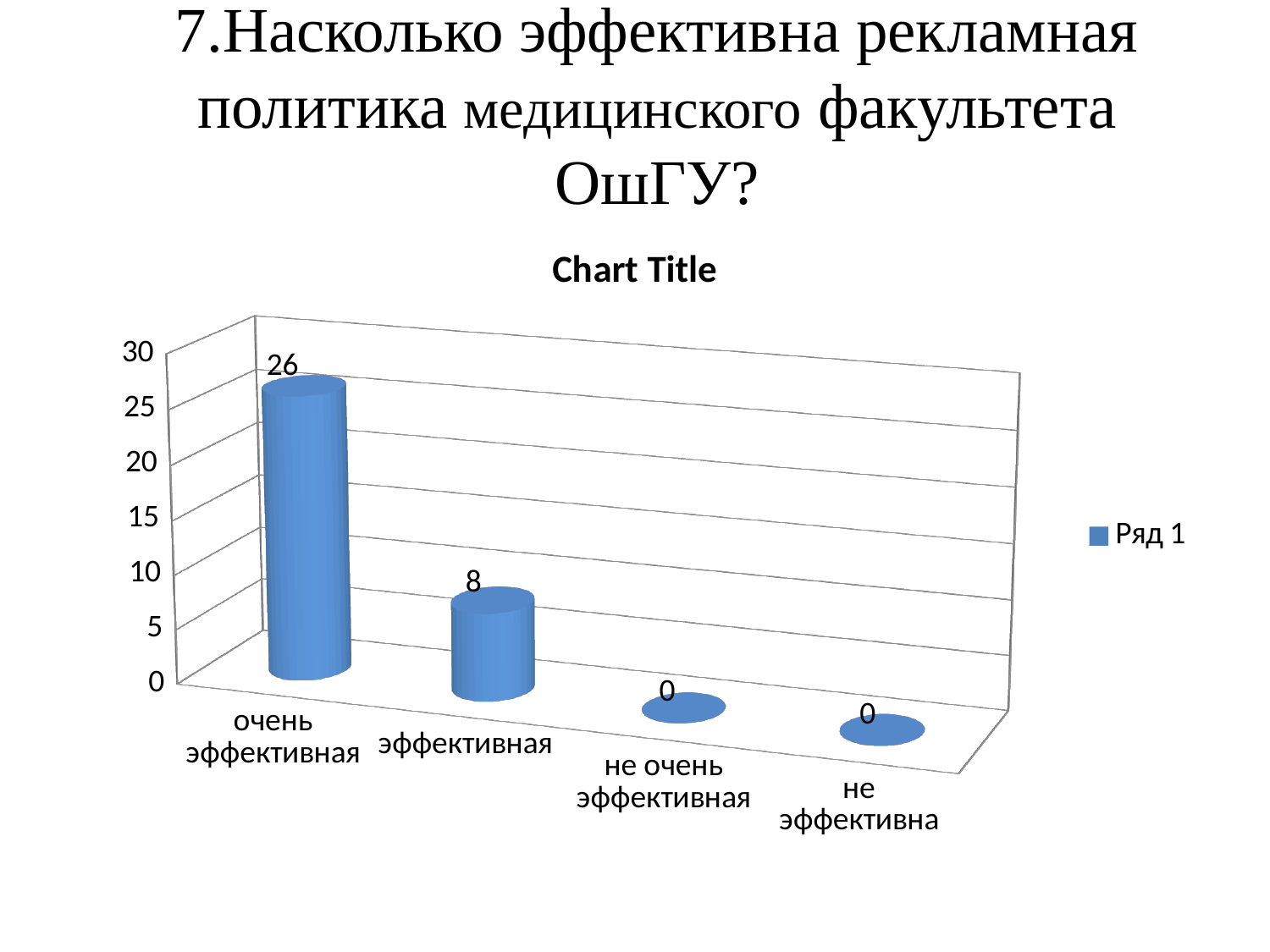
What is the value for "эффективная"? 8 What is the value for "очень эффективная"? 26 How many categories are shown on the x axis? 4 Is the value for "эффективная" greater or less than 10? less Is the value for "очень эффективная" greater or less than 20? greater How many series does the legend list? 1 Which category has the highest value? очень эффективная Which is larger, the value for "эффективная" or the value for "не очень эффективная"? эффективная What is the value for "не очень эффективная"? 0 What is the name of the series in the legend? Ряд 1 What kind of chart is shown? bar chart What is the difference between the values for "очень эффективная" and "эффективная"? 18